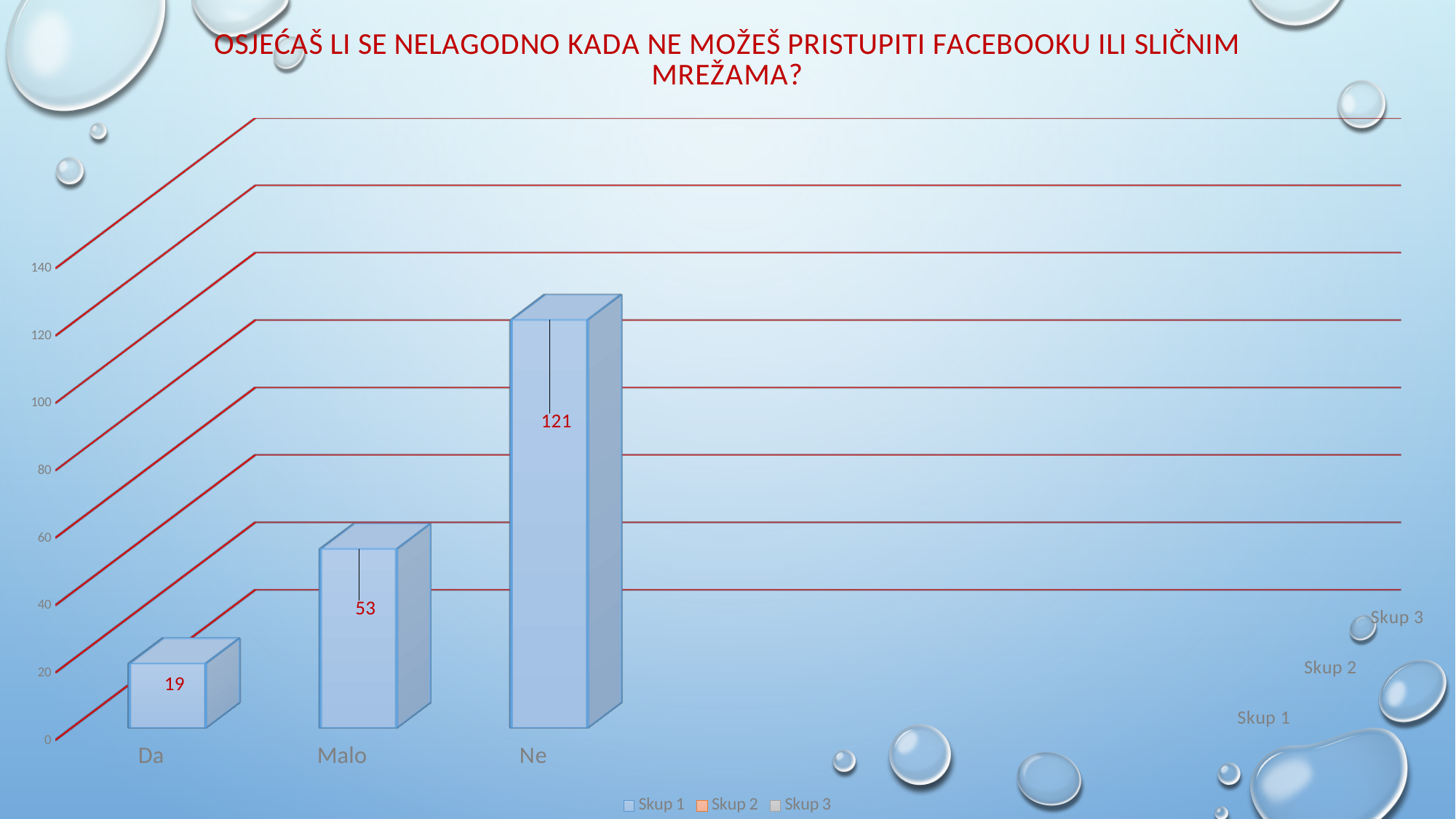
How many categories are shown on the x axis? 3 What is the value for Ne? 121 Which category has the highest value? Ne What kind of chart is shown on the slide? bar chart What is the value for Da? 19 Is the value for Ne greater or less than 100? greater What is the difference between the values for Ne and Malo? 68 What is the value for Malo? 53 Which category has the lowest value? Da Which is larger, the value for Da or the value for Malo? Malo What is the difference between the values for Malo and Da? 34 How many series does the legend list? 3